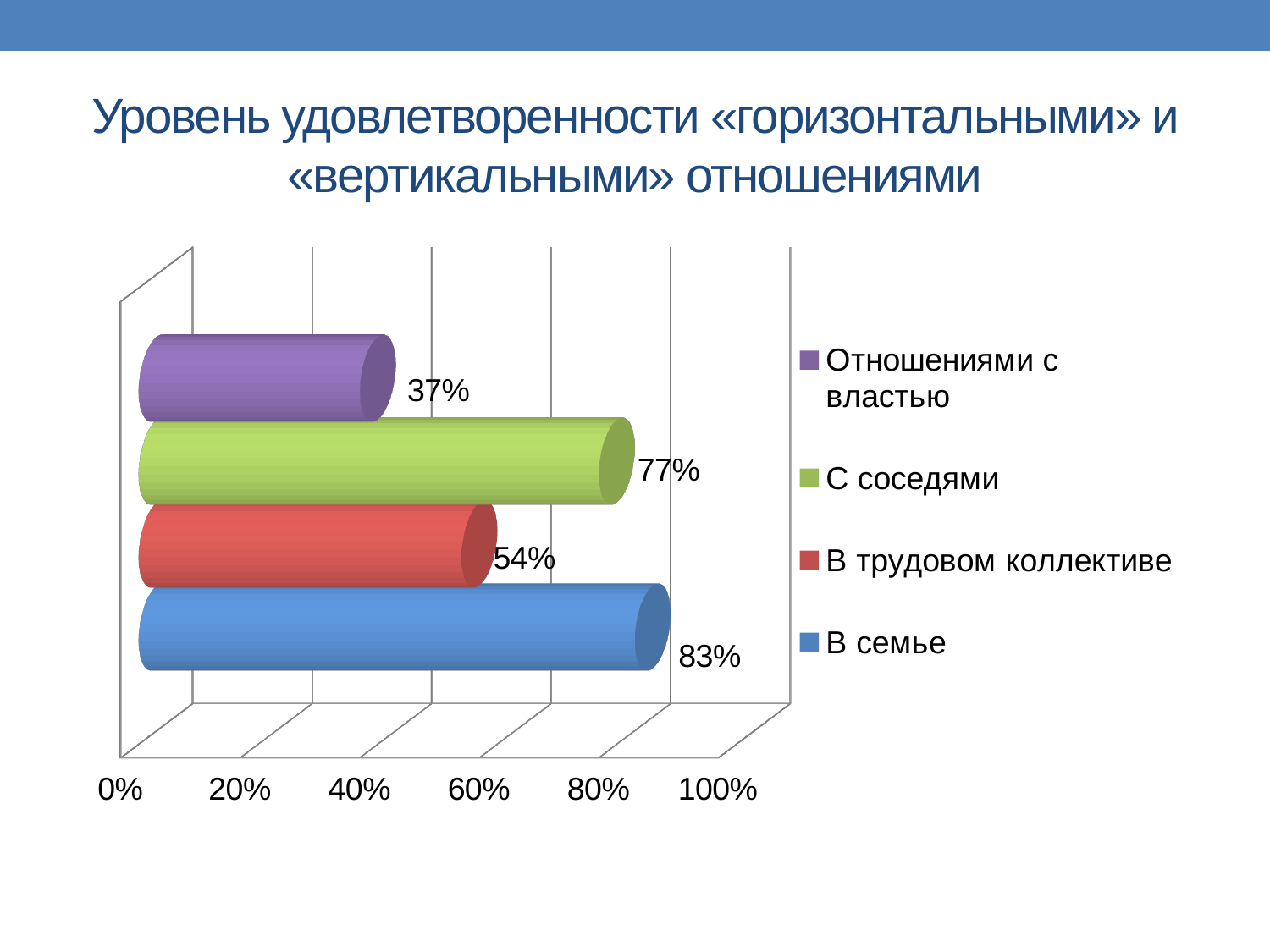
What is the value for «С соседями»? 77% What is the value for «В семье»? 83% What is the value for «Отношениями с властью»? 37% What is the difference between the values for «В семье» and «Отношениями с властью»? 46% Which category has the highest value? В семье Is the value for «В трудовом коллективе» greater or less than 60%? less How many categories are shown in the chart? 4 Which is larger, the value for «С соседями» or the value for «В трудовом коллективе»? С соседями What kind of chart is shown on the slide? bar chart What colour is the bar for «С соседями»? green Which category has the lowest value? Отношениями с властью What is the value for «В трудовом коллективе»? 54%